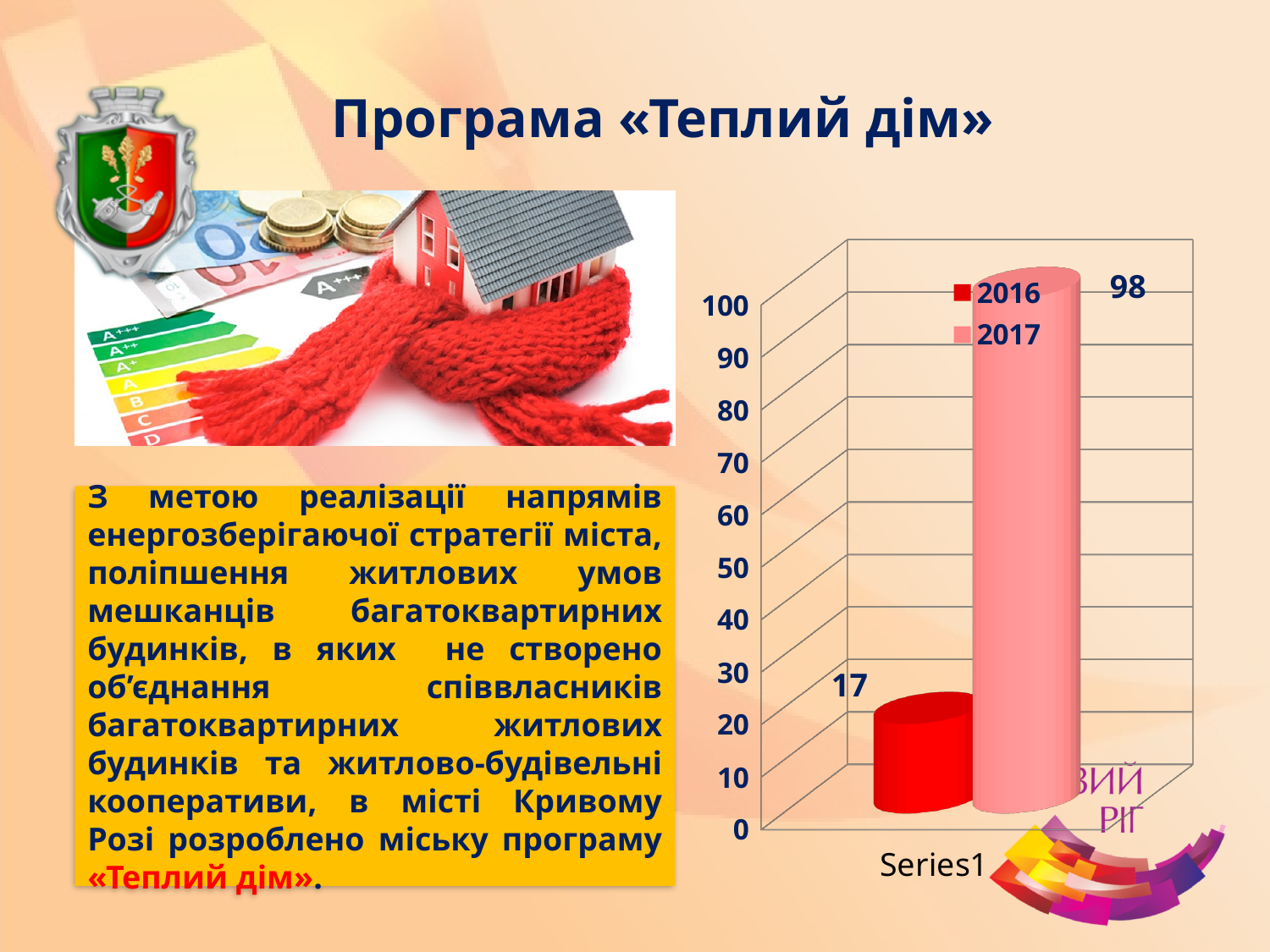
What is the value for 2016 on the chart? 17 What is the value for 2017 on the chart? 98 What kind of chart is shown on the slide? bar chart What is the highest value shown on the chart's vertical axis? 100 Is the value for 2017 greater or less than 90? greater What is the category label shown on the x axis of the chart? Series1 How many series does the legend list? 2 What is the difference between the 2017 value and the 2016 value? 81 Which series has the lower value on the chart? 2016 Which series has the higher value, 2016 or 2017? 2017 Is the value for 2016 greater or less than 20? less Is the value for 2017 greater or less than 50? greater